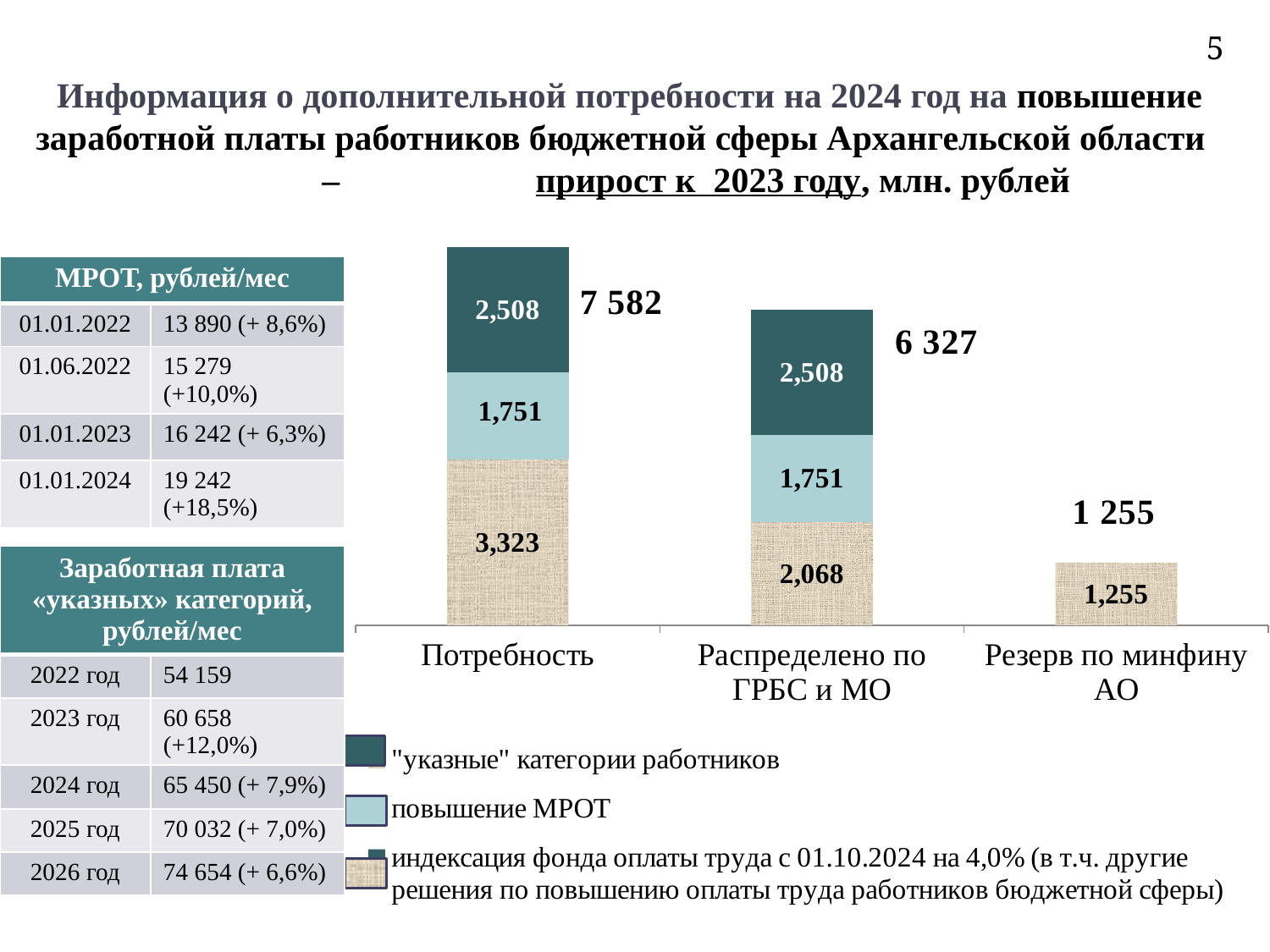
Which category has the lowest total? Резерв по минфину АО How many categories are shown on the x axis of the chart? 3 What type of chart is shown on the slide? stacked bar chart Which series is shown in the darkest colour in the legend? "указные" категории работников How many series does the chart legend list? 3 What is the value of the "индексация фонда оплаты труда" segment for Потребность? 3,323 What is the value of the "указные" категории работников segment for Потребность? 2,508 What is the difference between the "индексация фонда оплаты труда" segments for Потребность and Распределено по ГРБС и МО? 1,255 Which category has the highest total? Потребность What is the total shown above the Потребность bar? 7 582 What is the value of the "повышение МРОТ" segment for Распределено по ГРБС и МО? 1,751 What is the total shown above the Распределено по ГРБС и МО bar? 6 327